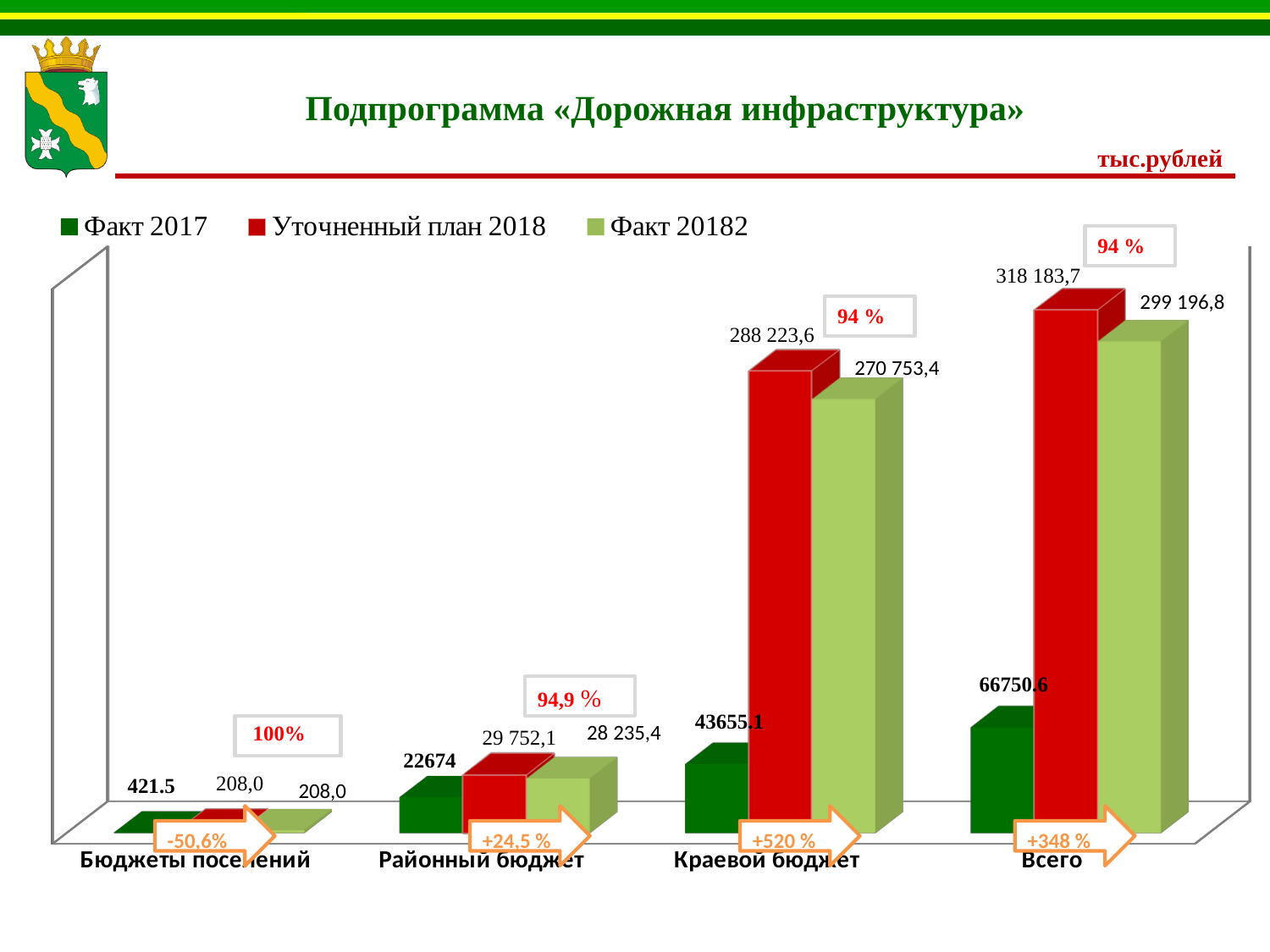
For Краевой бюджет, which is larger: Факт 2017 or Уточненный план 2018? Уточненный план 2018 What is the value of Факт 2017 for Всего? 66750.6 Which category has the highest value for Уточненный план 2018? Всего What is the value of the Факт 2018 series for Районный бюджет? 28 235,4 What is the value of Уточненный план 2018 for Бюджеты поселений? 208,0 What unit is stated for the values on the slide? тыс.рублей Which category has the lowest value for Факт 2017? Бюджеты поселений What type of chart is shown on the slide? bar chart How many categories are shown on the x axis? 4 How many series does the legend list? 3 What is the value of Уточненный план 2018 for Краевой бюджет? 288 223,6 What is the difference between Уточненный план 2018 and Факт 2018 for Всего? 18 986,9